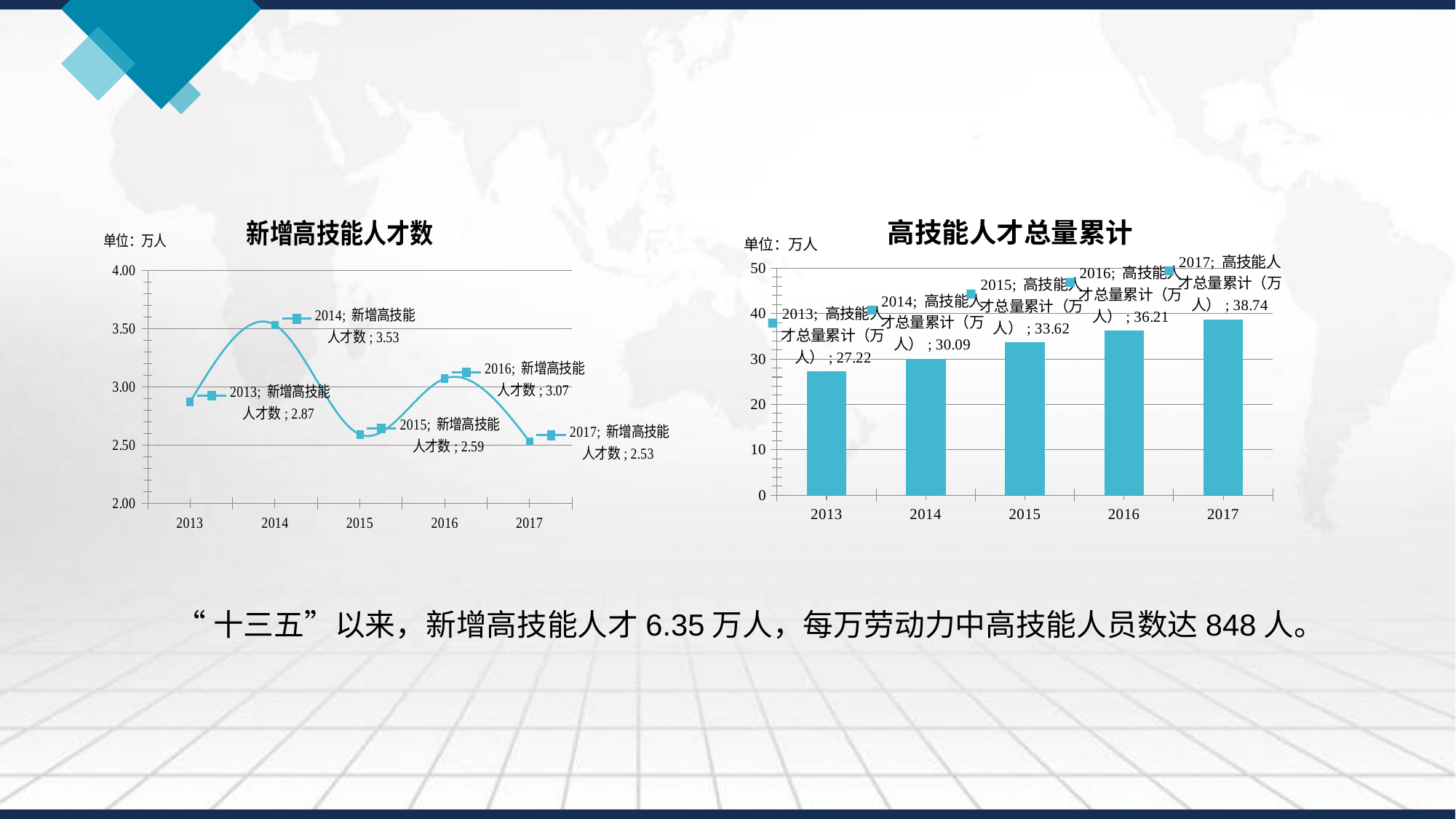
In the chart titled 高技能人才总量累计, which year has the highest value? 2017 In the chart titled 新增高技能人才数, what is the value for 2017? 2.53 In the chart titled 新增高技能人才数, what is the value for 2014? 3.53 In the chart titled 高技能人才总量累计, do the values rise or fall from 2013 to 2017? Rise In the chart titled 高技能人才总量累计, what is the value for 2013? 27.22 In the chart titled 高技能人才总量累计, what is the value for 2015? 33.62 How many years are shown on the x axis of the chart titled 高技能人才总量累计? 5 In the chart titled 新增高技能人才数, which year has the lowest value? 2017 In the chart titled 新增高技能人才数, which year has the highest value? 2014 In the chart titled 新增高技能人才数, what is the difference between the 2014 value and the 2015 value? 0.94 In the chart titled 高技能人才总量累计, what is the difference between the 2017 value and the 2016 value? 2.53 What kind of chart is the chart titled 新增高技能人才数? Line chart